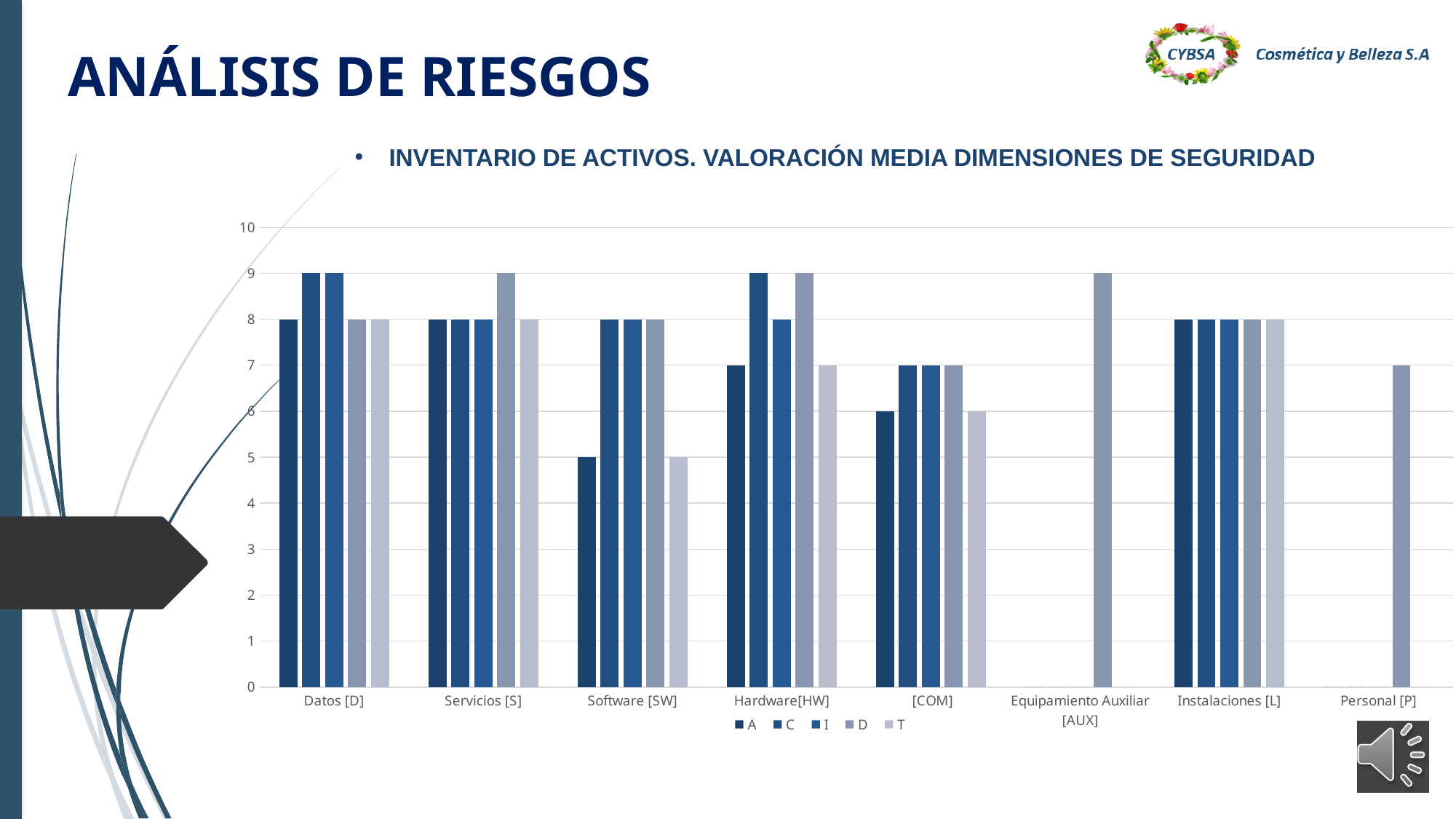
What is the value of series D for Personal [P]? 7 What is the value of series D for Equipamiento Auxiliar [AUX]? 9 What kind of chart is shown on the slide? bar chart Which is larger for Software [SW]: series C or series T? C What is the difference between series C and series A for Hardware[HW]? 2 How many asset categories are shown on the x axis? 8 What is the value of series A for Software [SW]? 5 What is the value of series C for Datos [D]? 9 Which series has the highest value for Servicios [S]? D Which series has the lowest value for [COM]? A and T How many series does the legend list? 5 Is the value of series A for [COM] greater or less than 8? less